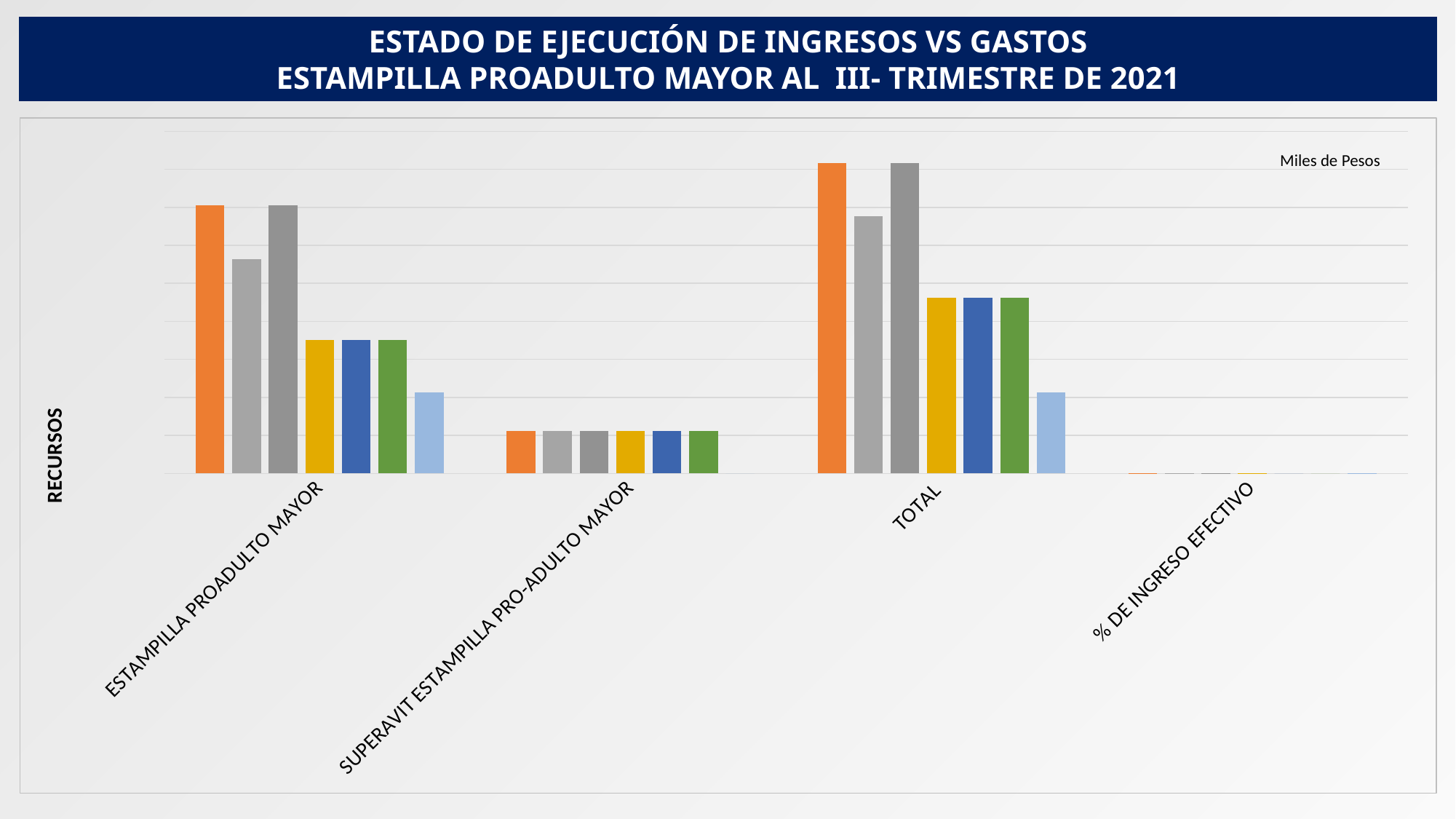
What unit note is printed in the top right corner of the chart area? Miles de Pesos Within the TOTAL category, is the light gray bar taller or shorter than the dark gray bar? Shorter How many categories are shown on the x axis of the chart? 4 What kind of chart is shown on the slide? Bar chart Which category has the smallest bars in the chart? % DE INGRESO EFECTIVO Are the bars for SUPERAVIT ESTAMPILLA PRO-ADULTO MAYOR taller or shorter than the bars for TOTAL? Shorter Which category has the tallest bars in the chart? TOTAL Is the orange bar for TOTAL taller or shorter than the orange bar for ESTAMPILLA PROADULTO MAYOR? Taller What is the label on the vertical axis of the chart? RECURSOS